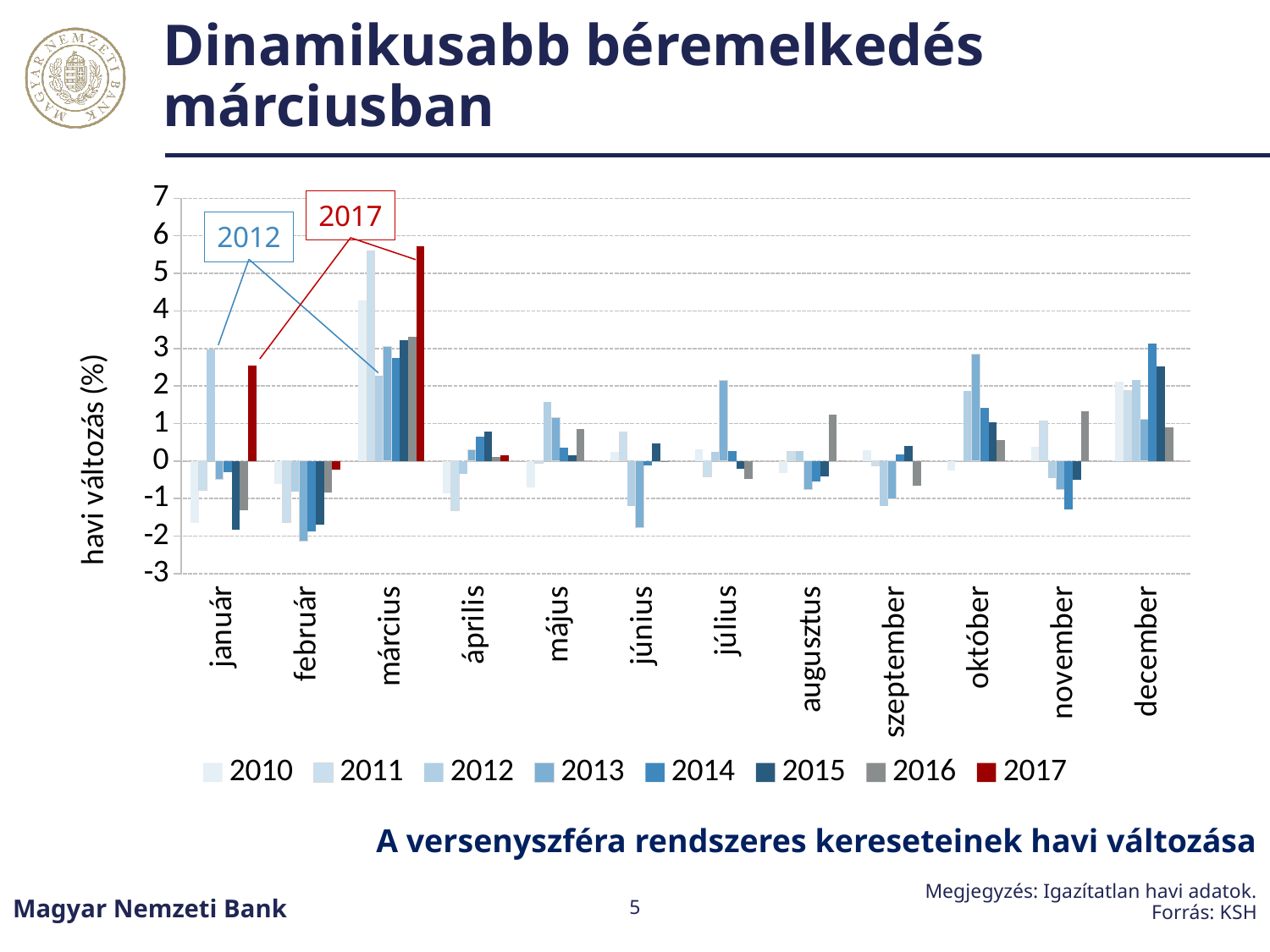
What is the label on the y axis? havi változás (%) Is the value for 2012 in március greater or less than 5? less Which series is drawn in dark red? 2017 Is the value for 2015 in január greater or less than -1? less How many months (categories) are shown on the x axis? 12 Which month has the highest value for the 2017 series? március Is the value for 2017 in január greater or less than 2? greater What kind of chart is shown on the slide? bar chart How many series does the legend list? 8 Which is larger for 2017: the value in január or the value in március? március